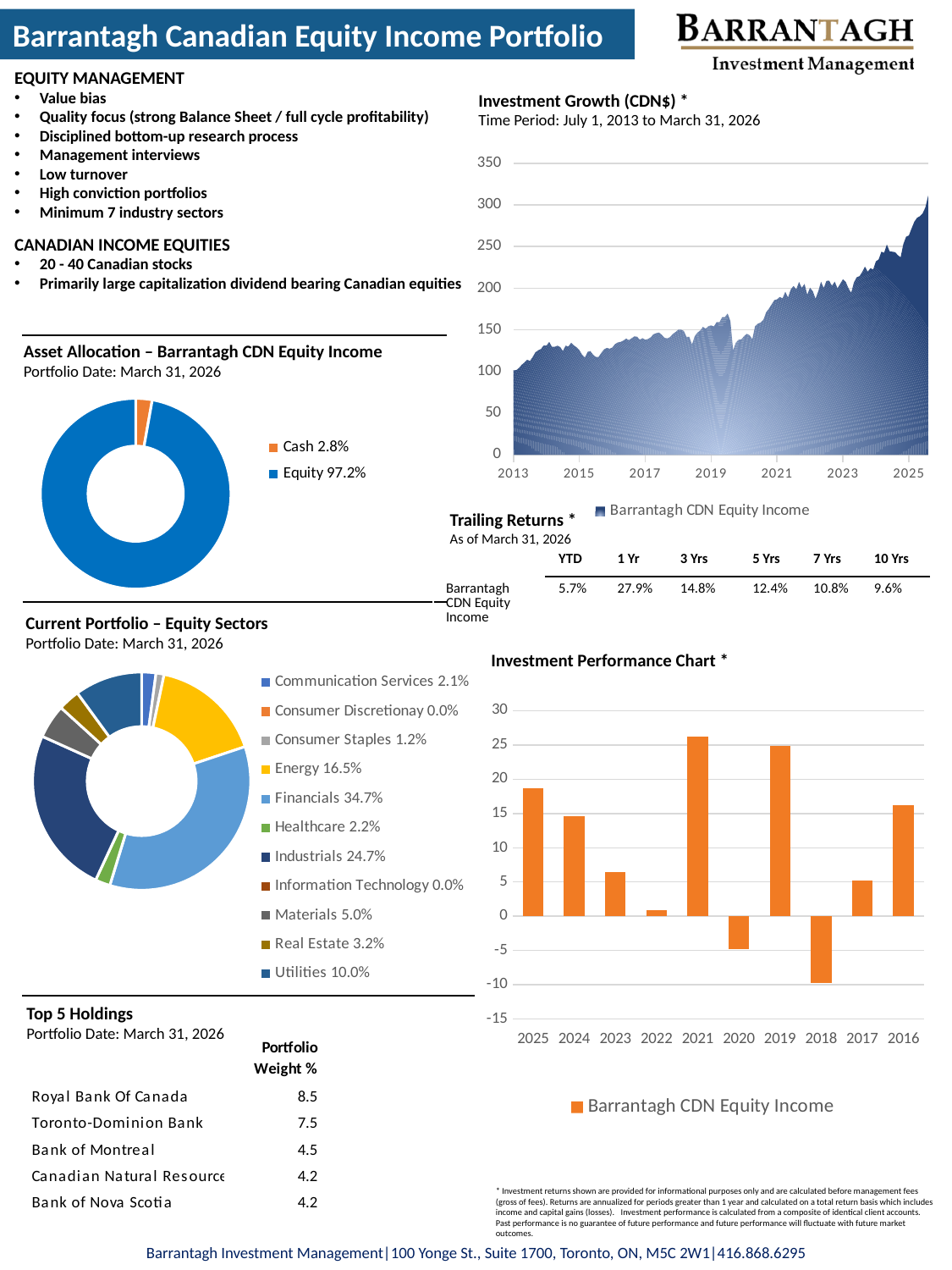
How many sectors does the legend of the Current Portfolio – Equity Sectors chart list? 11 In the Investment Performance Chart, which year has the lowest value? 2018 In the Asset Allocation chart, what is the value for Equity? 97.2% In the Investment Growth chart, do the values generally rise or fall from 2013 to 2025? rise In the Asset Allocation chart, what is the value for Cash? 2.8% In the Current Portfolio – Equity Sectors chart, what is the value for Industrials? 24.7% In the Investment Performance Chart, is the value for 2018 greater or less than -5? less How many years are shown on the x axis of the Investment Performance Chart? 10 In the Investment Performance Chart, is the value for 2021 greater or less than 25? greater In the Current Portfolio – Equity Sectors chart, which is larger, Energy or Utilities? Energy In the Current Portfolio – Equity Sectors chart, what is the difference between Financials and Industrials? 10.0% In the Current Portfolio – Equity Sectors chart, which sector has the highest weight? Financials